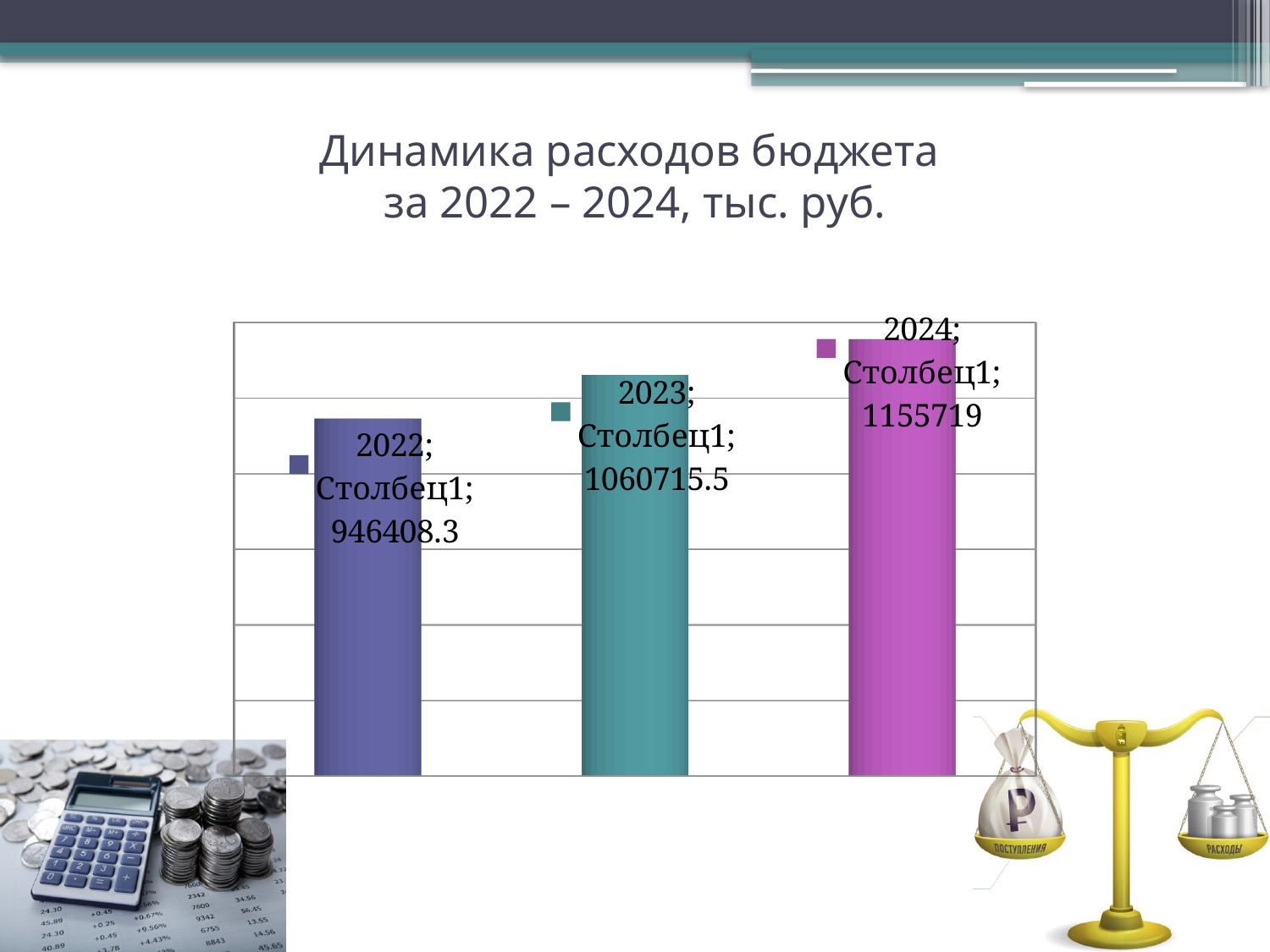
What is the difference between the values for 2024 and 2023? 95003.5 What is the value for 2022? 946408.3 How many bars are plotted in the chart? 3 What kind of chart is shown on the slide? bar chart What is the value for 2024? 1155719 Which year has the lowest value? 2022 Which year has the highest value? 2024 Which is larger, the value for 2022 or the value for 2024? 2024 What is the value for 2023? 1060715.5 What is the difference between the values for 2023 and 2022? 114307.2 Do the values rise or fall from 2022 to 2024? rise What is the difference between the values for 2024 and 2022? 209310.7